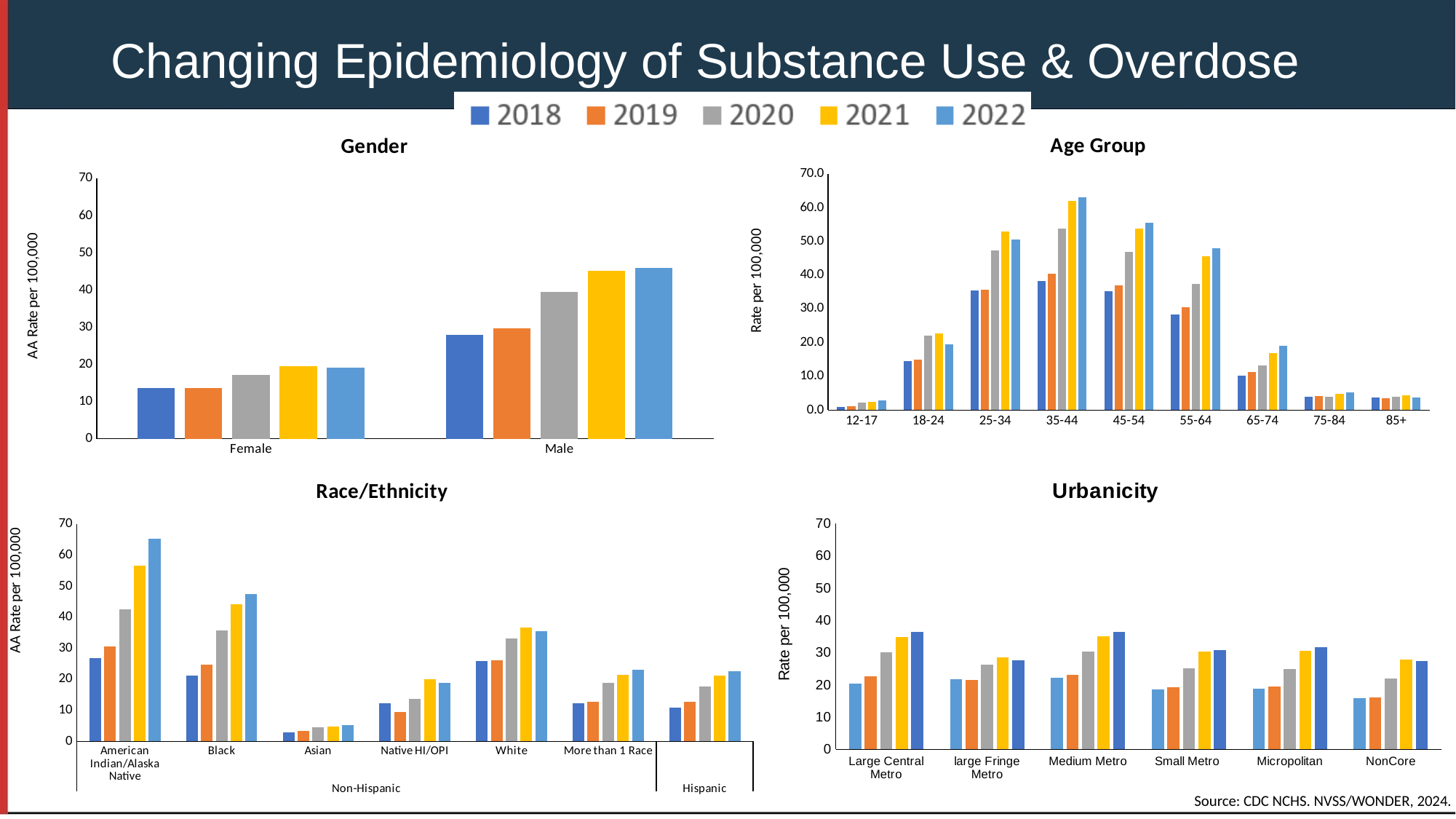
In the Urbanicity chart, which is larger in 2022: Large Central Metro or NonCore? Large Central Metro What kind of chart is the Gender chart? bar chart In the Age Group chart, which age group has the lowest 2018 value? 12-17 In the Race/Ethnicity chart, which category has the highest 2022 value? American Indian/Alaska Native In the Age Group chart, which age group has the highest 2022 value? 35-44 In the Race/Ethnicity chart, how many race/ethnicity categories are shown on the x axis? 7 In the Race/Ethnicity chart, do the values for American Indian/Alaska Native rise or fall from 2018 to 2022? rise In the Age Group chart, how many age categories are shown on the x axis? 9 In the Race/Ethnicity chart, is the value for American Indian/Alaska Native in 2022 greater or less than 60? greater How many series does the shared legend at the top of the slide list? 5 In the Gender chart, is the value for Male in 2022 greater or less than 40? greater